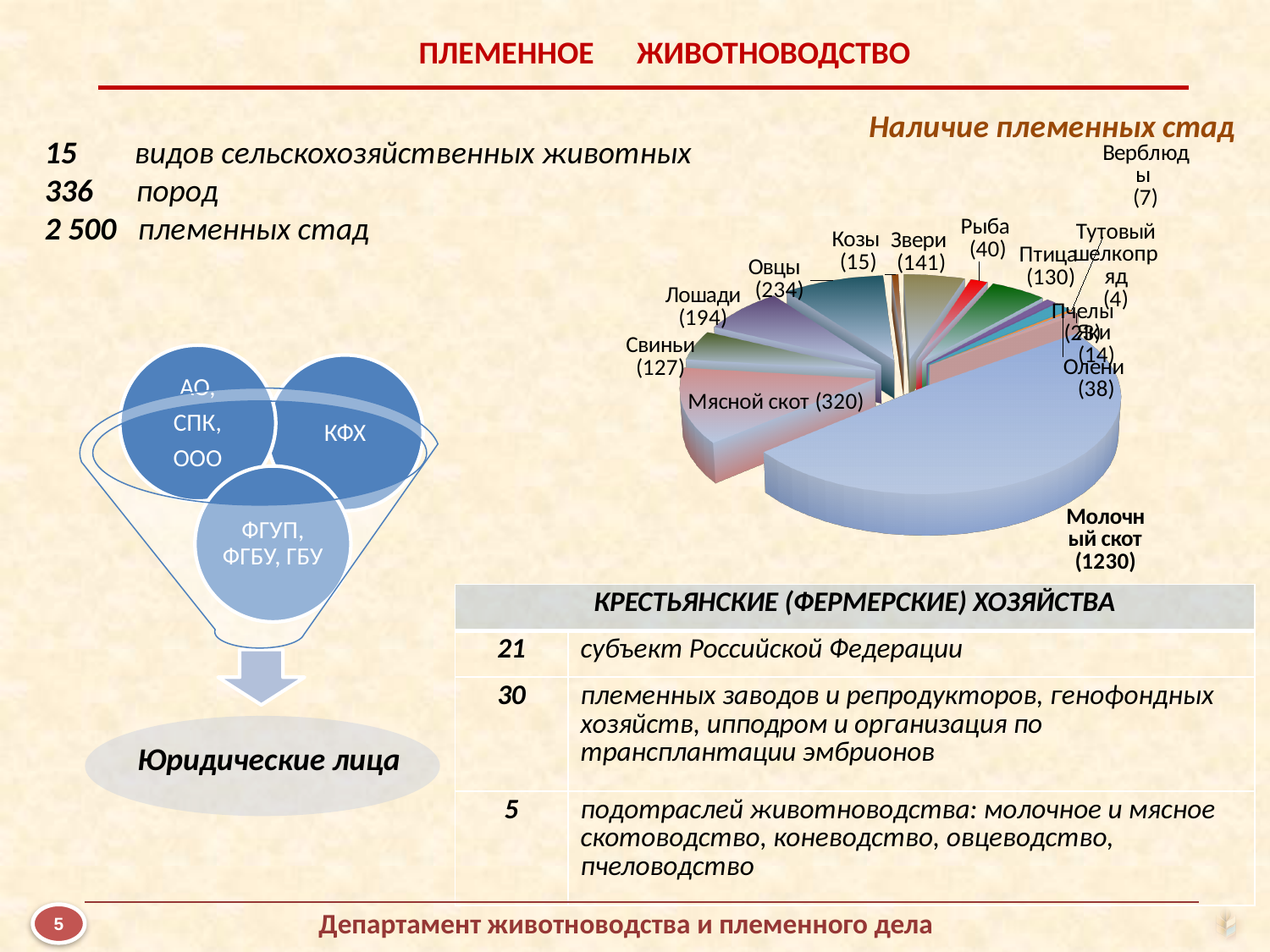
In the pie chart 'Наличие племенных стад', what is the value for Лошади? 194 In the pie chart 'Наличие племенных стад', what is the value for Овцы? 234 In the pie chart 'Наличие племенных стад', what is the value for Мясной скот? 320 What kind of chart is shown on the right side of the slide? Pie chart In the pie chart 'Наличие племенных стад', which is larger: Звери or Птица? Звери In the pie chart 'Наличие племенных стад', which category has the largest value? Молочный скот In the pie chart 'Наличие племенных стад', which category has the smallest value? Тутовый шелкопряд What is the title of the pie chart on the slide? Наличие племенных стад In the pie chart 'Наличие племенных стад', what is the value for Верблюды? 7 In the pie chart 'Наличие племенных стад', what is the value for Молочный скот? 1230 In the pie chart 'Наличие племенных стад', what is the difference between Мясной скот and Свиньи? 193 In the pie chart 'Наличие племенных стад', what is the difference between Молочный скот and Мясной скот? 910